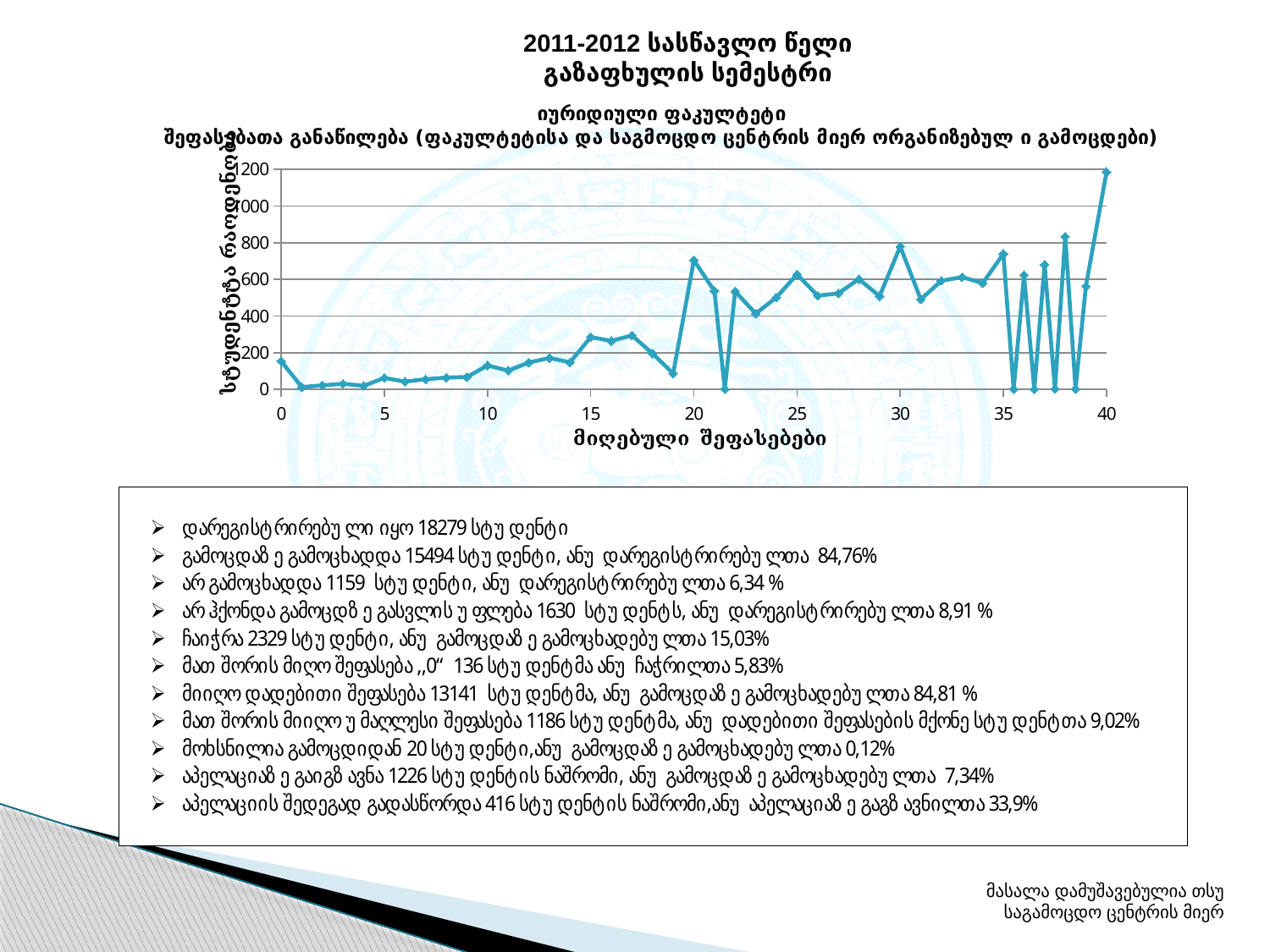
What is the title of the x-axis? მიღებული შეფასებები Is the value at x = 15 greater or less than 400? less Is the value at x = 20 greater or less than 600? greater What kind of chart is shown on the slide? line chart Which is larger, the value at x = 20 or the value at x = 10? x = 20 Is the value at x = 40 greater or less than 1000? greater What is the highest tick value shown on the y-axis? 1200 Which is larger, the value at x = 30 or the value at x = 15? x = 30 At which x-axis value (received grade) does the line reach its highest point? 40